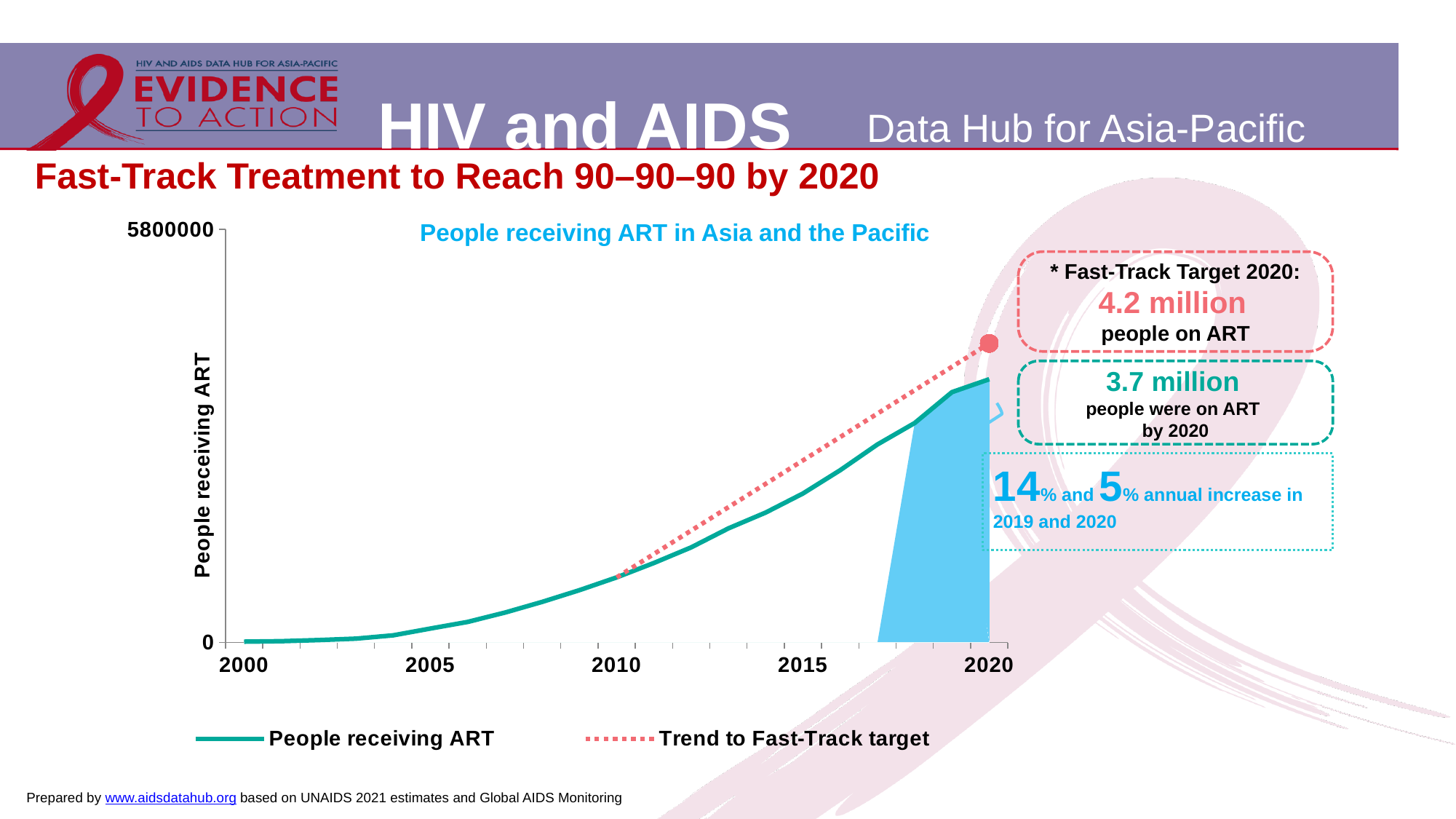
By how much did the number of people on ART by 2020 fall short of the Fast-Track Target 2020? 0.5 million Is the value for people receiving ART in 2020 greater or less than 5800000? less What are the two series named in the legend? People receiving ART; Trend to Fast-Track target How many people were on ART by 2020 according to the slide? 3.7 million Which is larger: the Fast-Track Target 2020 or the number of people actually on ART by 2020? Fast-Track Target 2020 How many series does the chart legend list? 2 What is the title of the chart? People receiving ART in Asia and the Pacific What was the annual increase in people receiving ART in 2020? 5% Does the number of people receiving ART rise or fall from 2000 to 2020? Rise What is the Fast-Track Target 2020 for people on ART? 4.2 million What was the annual increase in people receiving ART in 2019? 14% What kind of chart is shown on the slide? Line chart